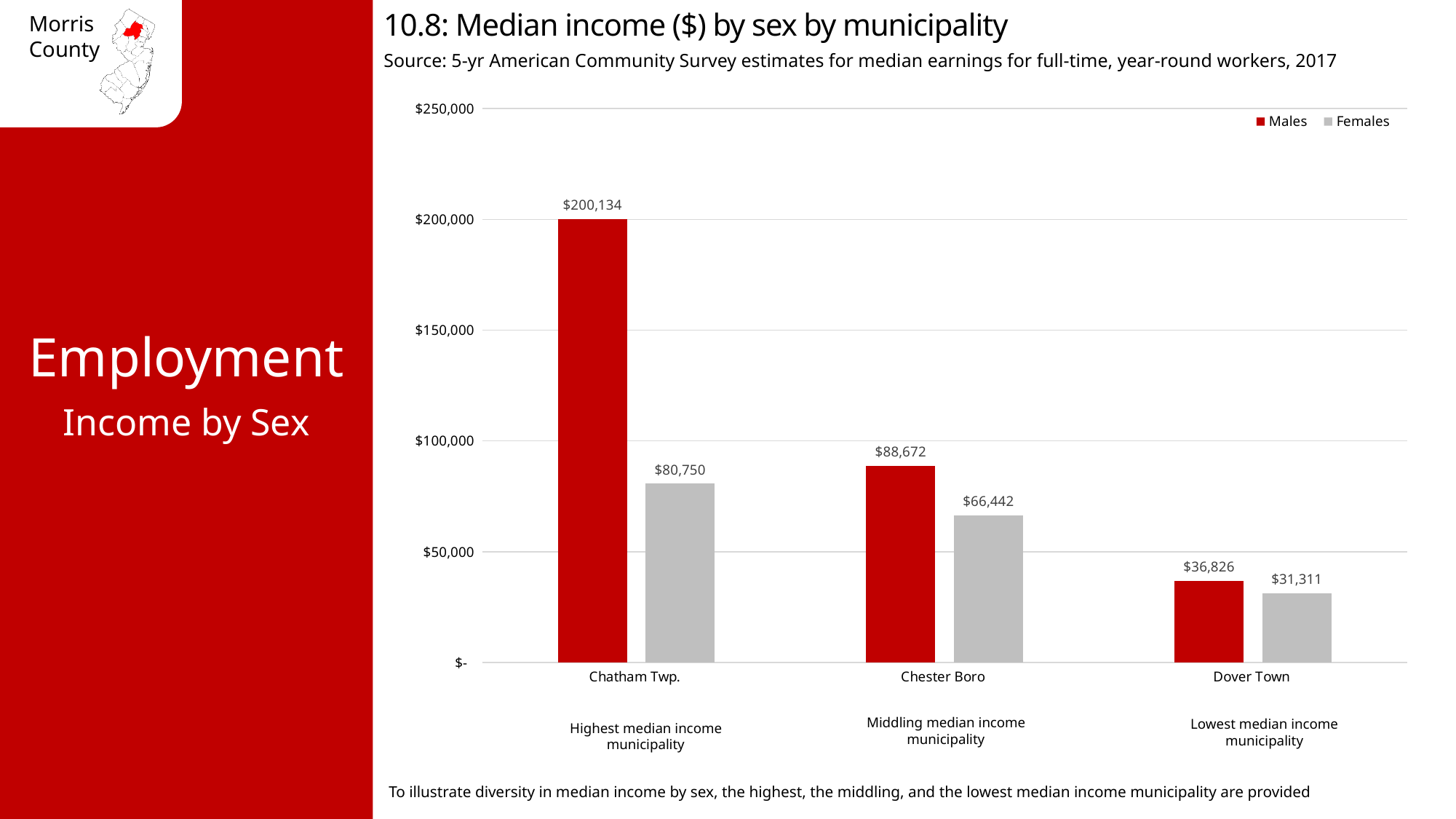
What is the median income for females in Dover Town? $31,311 What is the median income for males in Chatham Twp.? $200,134 What type of chart is shown on the slide? Bar chart Which municipality has the highest median income for females? Chatham Twp. What is the median income for females in Chester Boro? $66,442 Which municipality has the lowest median income for males? Dover Town Which is larger: the female median income in Chatham Twp. or the male median income in Chester Boro? Male median income in Chester Boro What is the difference between male and female median income in Chatham Twp.? $119,384 How many series does the legend list? 2 What is the median income for males in Dover Town? $36,826 How many municipalities are shown on the x axis? 3 What is the difference between male and female median income in Dover Town? $5,515